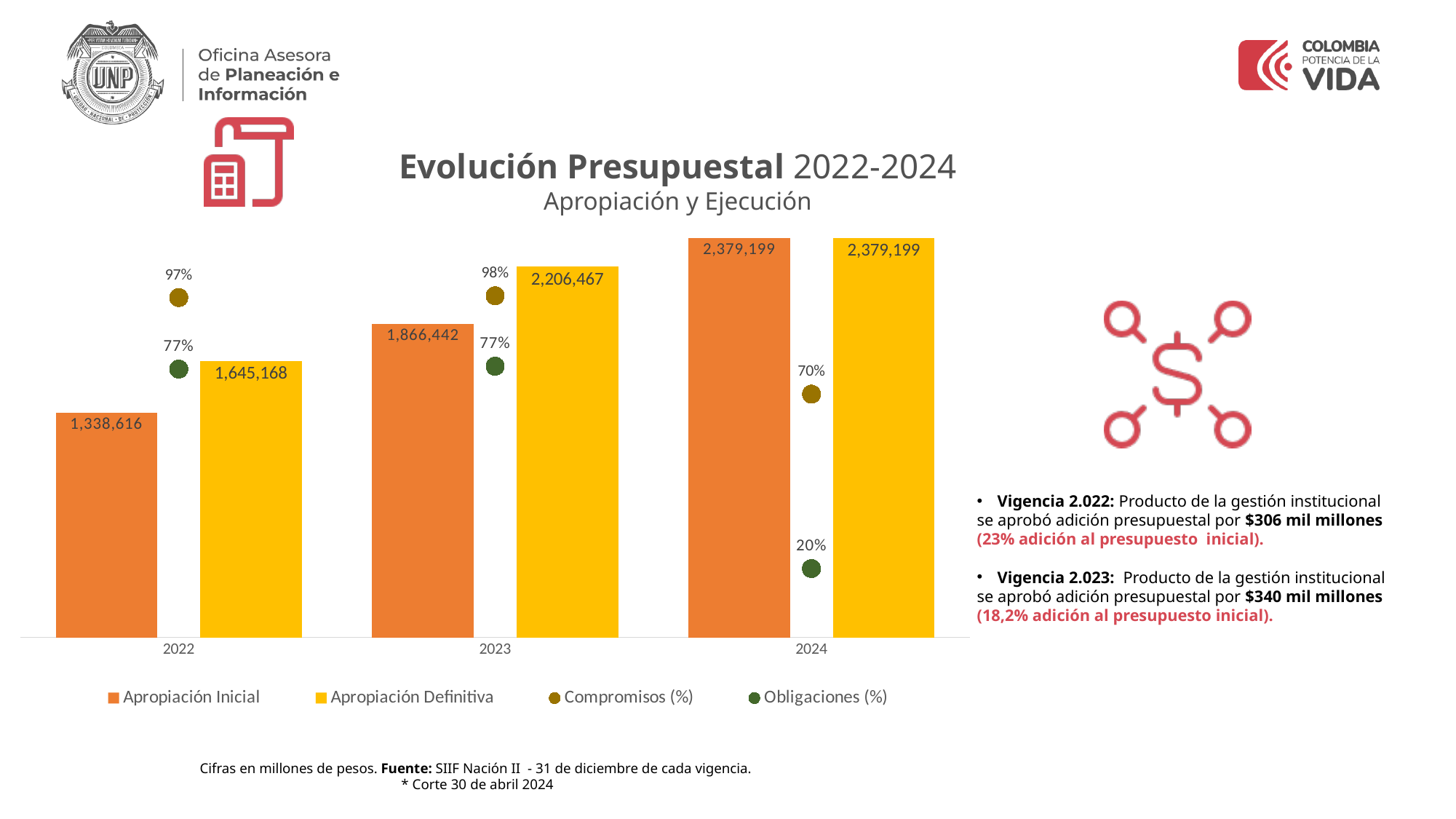
Which year has the lowest Obligaciones (%)? 2024 What is the Apropiación Definitiva value for 2023? 2,206,467 Does the Apropiación Inicial rise or fall from 2022 to 2024? rise What is the difference between Apropiación Definitiva and Apropiación Inicial in 2023? 340,025 How many years are shown on the x axis of the chart? 3 What is the Compromisos (%) value for 2024? 70% Which year has the highest Apropiación Definitiva? 2024 How many series does the chart legend list? 4 What is the difference between Apropiación Definitiva and Apropiación Inicial in 2022? 306,552 What is the Apropiación Inicial value for 2022? 1,338,616 What is the Obligaciones (%) value for 2022? 77% Which is larger in 2022, Apropiación Inicial or Apropiación Definitiva? Apropiación Definitiva